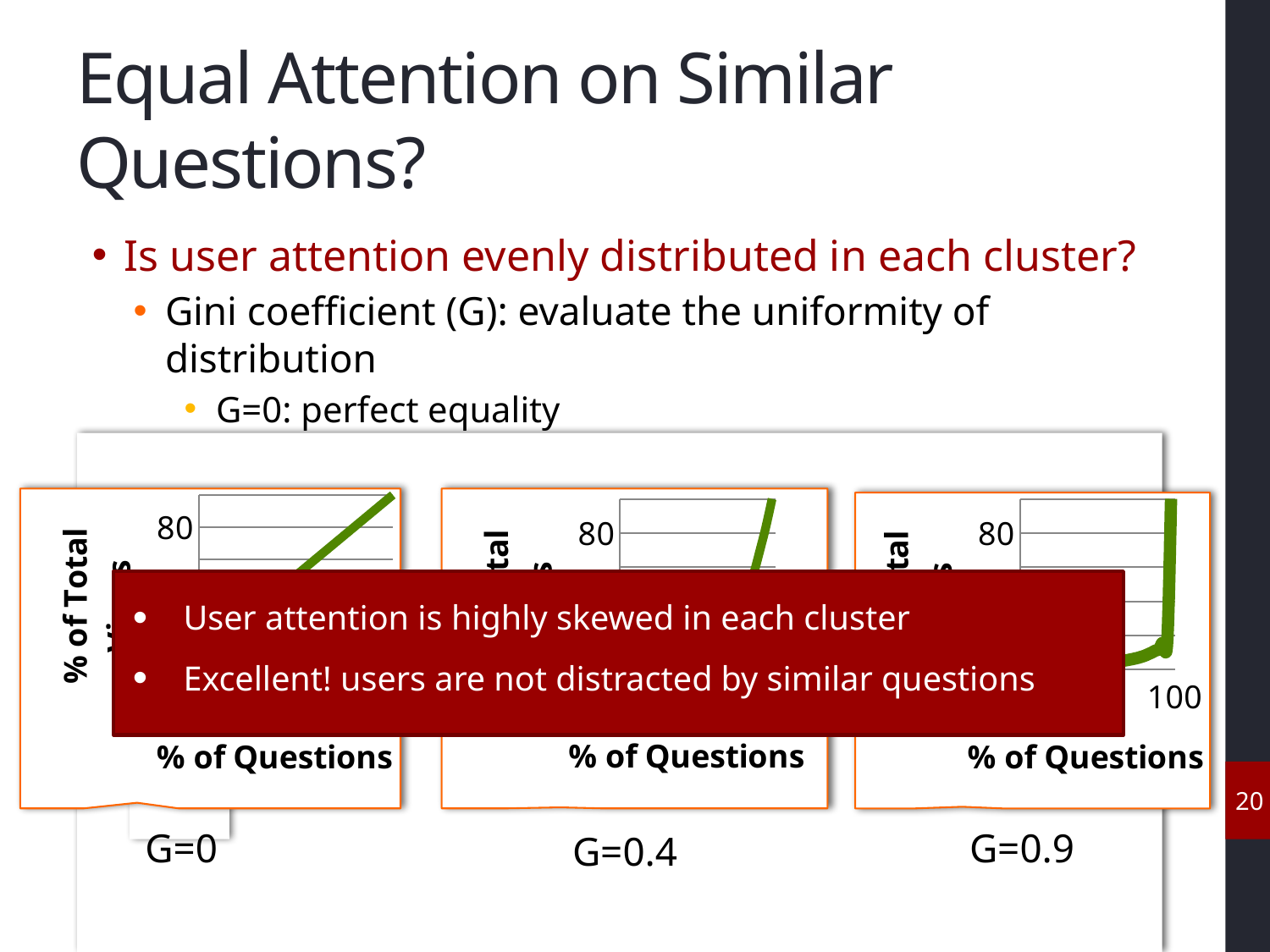
What kind of chart is shown under the label G=0? line chart What x-axis tick value is shown at the right end of the chart labeled G=0.9? 100 What Gini coefficient value is labeled under the rightmost chart? G=0.9 In the chart labeled G=0, does the plotted line rise or fall along the x axis? rise What colour is the plotted line in the three charts? green What Gini coefficient value is labeled under the middle chart? G=0.4 How many charts are shown on the slide? 3 What Gini coefficient value is labeled under the leftmost chart? G=0 What is the x-axis label of the chart labeled G=0.4? % of Questions In the chart labeled G=0.4, does the plotted line rise or fall along the x axis? rise In the chart labeled G=0.9, does the plotted line rise or fall along the x axis? rise